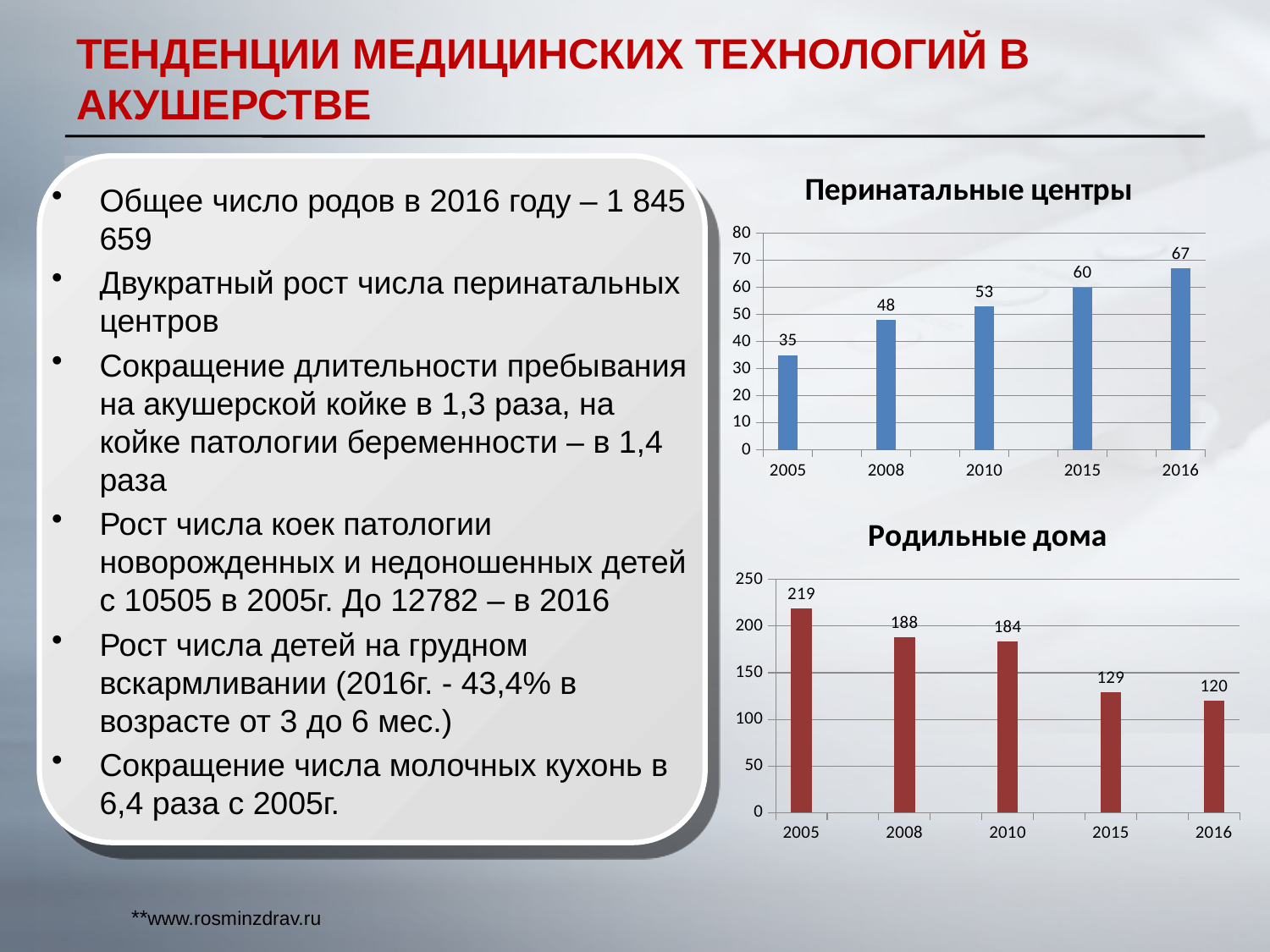
In the 'Перинатальные центры' chart, what is the difference between the values for 2016 and 2005? 32 In the 'Родильные дома' chart, what is the difference between the values for 2005 and 2016? 99 In the 'Перинатальные центры' chart, how many years are shown on the x axis? 5 In the 'Родильные дома' chart, which year has the lowest value? 2016 In the 'Перинатальные центры' chart, which year has the highest value? 2016 In the 'Перинатальные центры' chart, do the values rise or fall from 2005 to 2016? rise In the 'Перинатальные центры' chart, what is the value for 2010? 53 What colour are the bars in the 'Перинатальные центры' chart? blue In the 'Родильные дома' chart, what is the value for 2008? 188 In the 'Родильные дома' chart, do the values rise or fall from 2005 to 2016? fall In the 'Родильные дома' chart, which is larger, the value for 2010 or the value for 2015? 2010 What type of chart is the 'Родильные дома' chart? bar chart